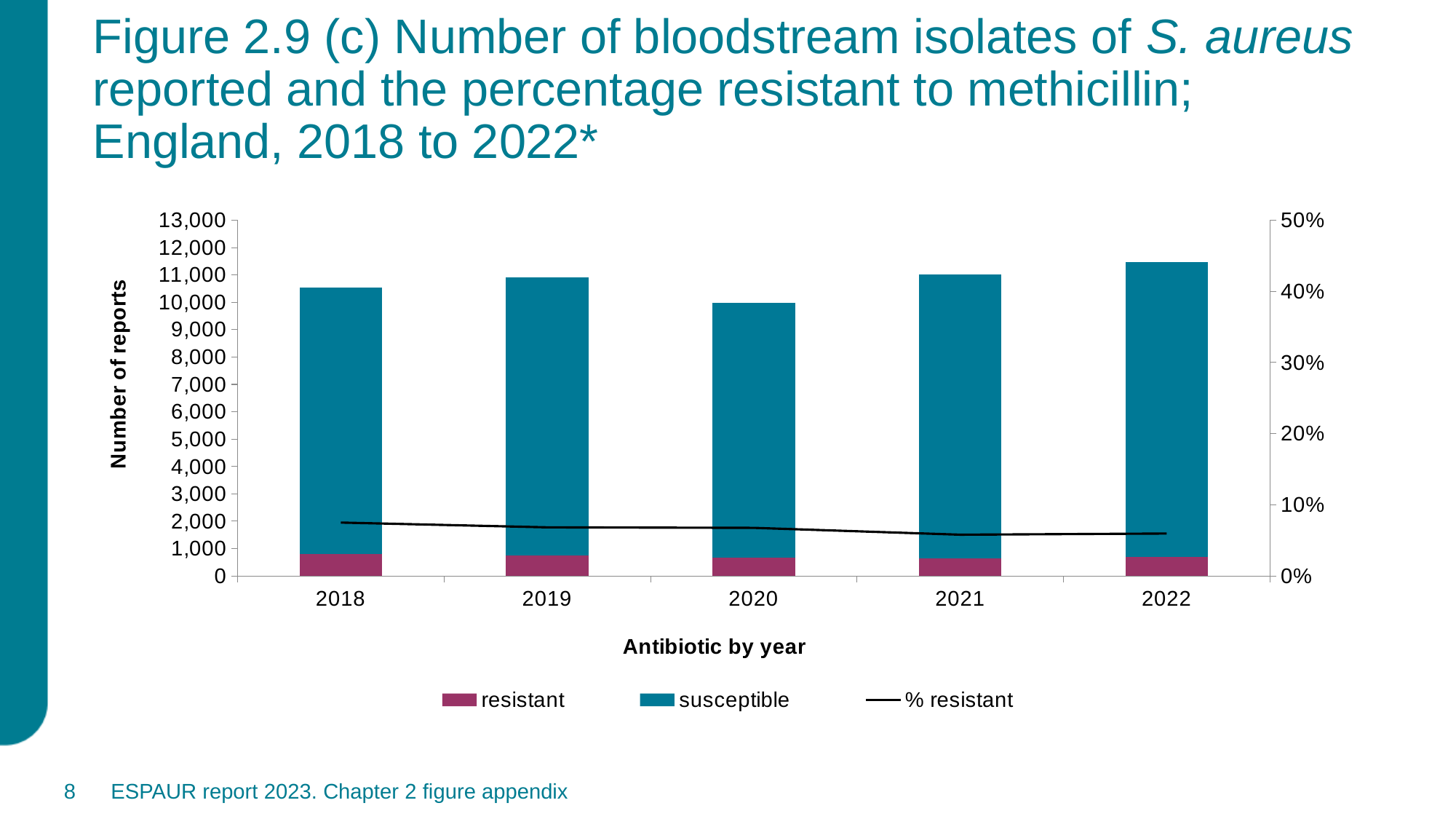
Does the % resistant line generally rise or fall from 2018 to 2021? fall What is the title of the x axis? Antibiotic by year Which is larger, the total number of reports in 2022 or in 2020? 2022 Is the total number of reports for 2018 greater or less than 10,000? greater Is the total number of reports for 2020 greater or less than 11,000? less Is the total number of reports for 2022 greater or less than 11,000? greater What kind of chart is shown on the slide? combination bar and line chart How many series does the legend list? 3 Which year has the lowest total number of reports? 2020 Which year has the highest total number of reports? 2022 How many years are shown on the x axis? 5